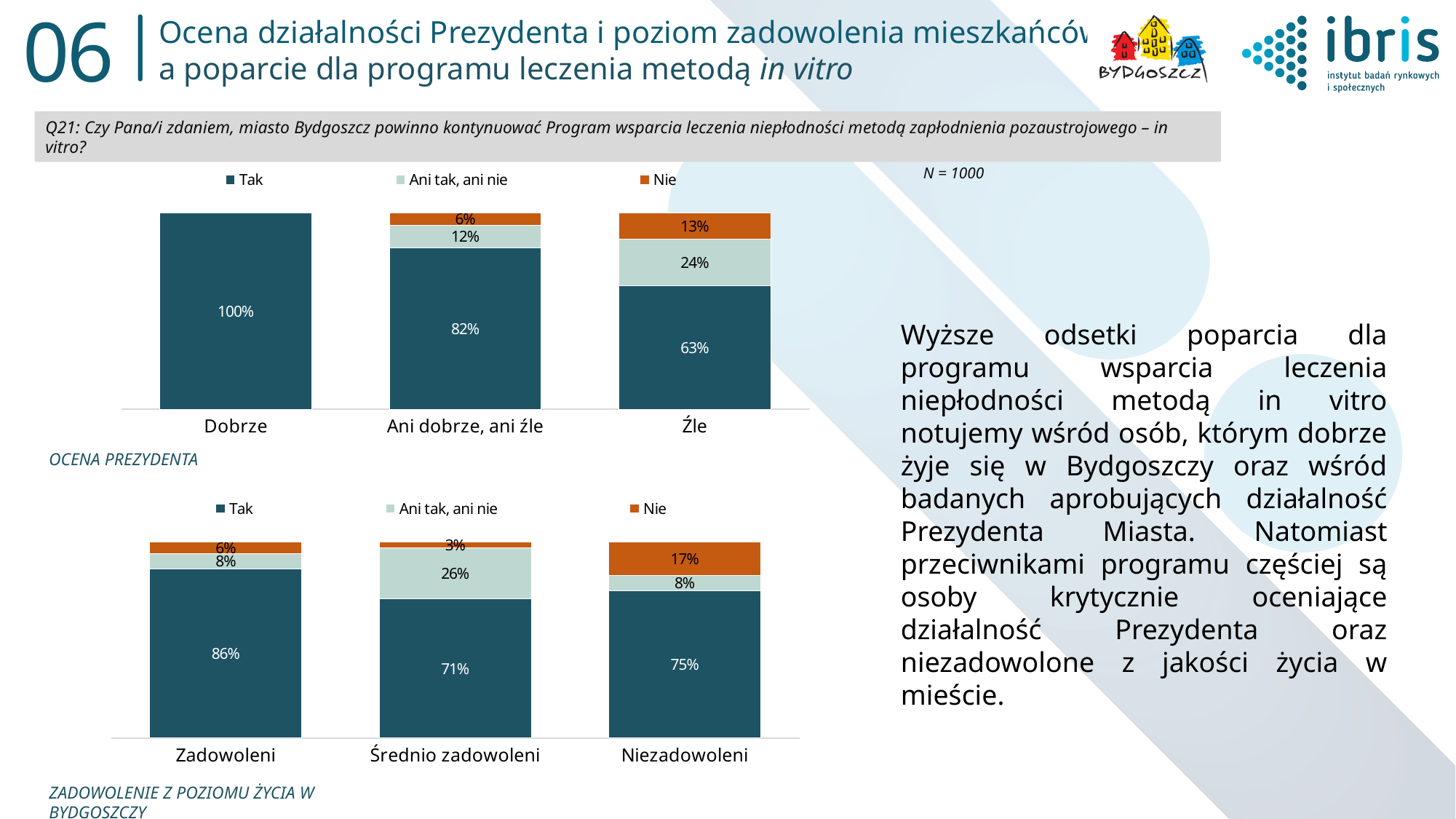
In the top chart (OCENA PREZYDENTA), what is the difference between the 'Tak' values for 'Dobrze' and 'Źle'? 37 percentage points In the bottom chart (ZADOWOLENIE Z POZIOMU ŻYCIA W BYDGOSZCZY), what is the difference between the 'Nie' values for 'Niezadowoleni' and 'Zadowoleni'? 11 percentage points In the bottom chart (ZADOWOLENIE Z POZIOMU ŻYCIA W BYDGOSZCZY), which category has the highest 'Tak' value? Zadowoleni In the top chart (OCENA PREZYDENTA), what is the 'Tak' value for the 'Dobrze' category? 100% What type of chart is the bottom chart (ZADOWOLENIE Z POZIOMU ŻYCIA W BYDGOSZCZY)? Stacked bar chart In the top chart (OCENA PREZYDENTA), what is the 'Nie' value for the 'Źle' category? 13% In the top chart (OCENA PREZYDENTA), which category has the lowest 'Tak' value? Źle In the bottom chart (ZADOWOLENIE Z POZIOMU ŻYCIA W BYDGOSZCZY), what is the 'Nie' value for 'Niezadowoleni'? 17% In the bottom chart (ZADOWOLENIE Z POZIOMU ŻYCIA W BYDGOSZCZY), is the 'Ani tak, ani nie' value larger for 'Średnio zadowoleni' or for 'Zadowoleni'? Średnio zadowoleni In the bottom chart (ZADOWOLENIE Z POZIOMU ŻYCIA W BYDGOSZCZY), what is the 'Tak' value for 'Średnio zadowoleni'? 71% In the top chart (OCENA PREZYDENTA), what is the 'Ani tak, ani nie' value for 'Ani dobrze, ani źle'? 12% How many series does the legend of the top chart (OCENA PREZYDENTA) list? 3